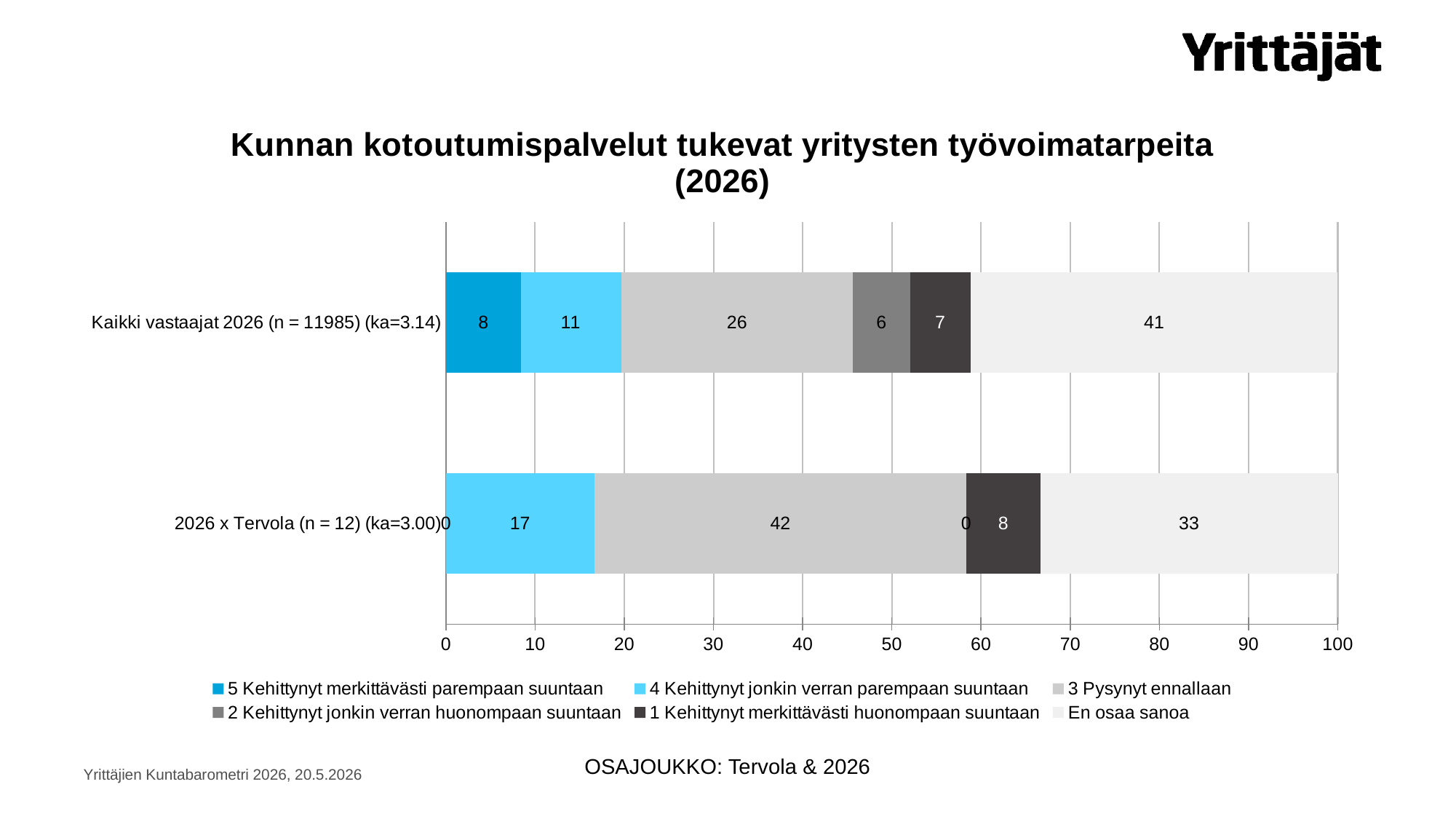
Which category has the larger value for "4 Kehittynyt jonkin verran parempaan suuntaan"? 2026 x Tervola (n = 12) (ka=3.00) What is the value of "4 Kehittynyt jonkin verran parempaan suuntaan" for "Kaikki vastaajat 2026 (n = 11985) (ka=3.14)"? 11 Which segment is the largest in the "2026 x Tervola (n = 12) (ka=3.00)" bar? 3 Pysynyt ennallaan What is the value of "5 Kehittynyt merkittävästi parempaan suuntaan" for "2026 x Tervola (n = 12) (ka=3.00)"? 0 How many series does the legend list? 6 What is the difference between the "3 Pysynyt ennallaan" values for "2026 x Tervola (n = 12) (ka=3.00)" and "Kaikki vastaajat 2026 (n = 11985) (ka=3.14)"? 16 What is the title of the chart? Kunnan kotoutumispalvelut tukevat yritysten työvoimatarpeita (2026) How many categories (bars) are plotted in the chart? 2 What kind of chart is shown on the slide? Stacked bar chart Which segment is the largest in the "Kaikki vastaajat 2026 (n = 11985) (ka=3.14)" bar? En osaa sanoa What is the value of "En osaa sanoa" for "Kaikki vastaajat 2026 (n = 11985) (ka=3.14)"? 41 What is the value of "3 Pysynyt ennallaan" for "2026 x Tervola (n = 12) (ka=3.00)"? 42